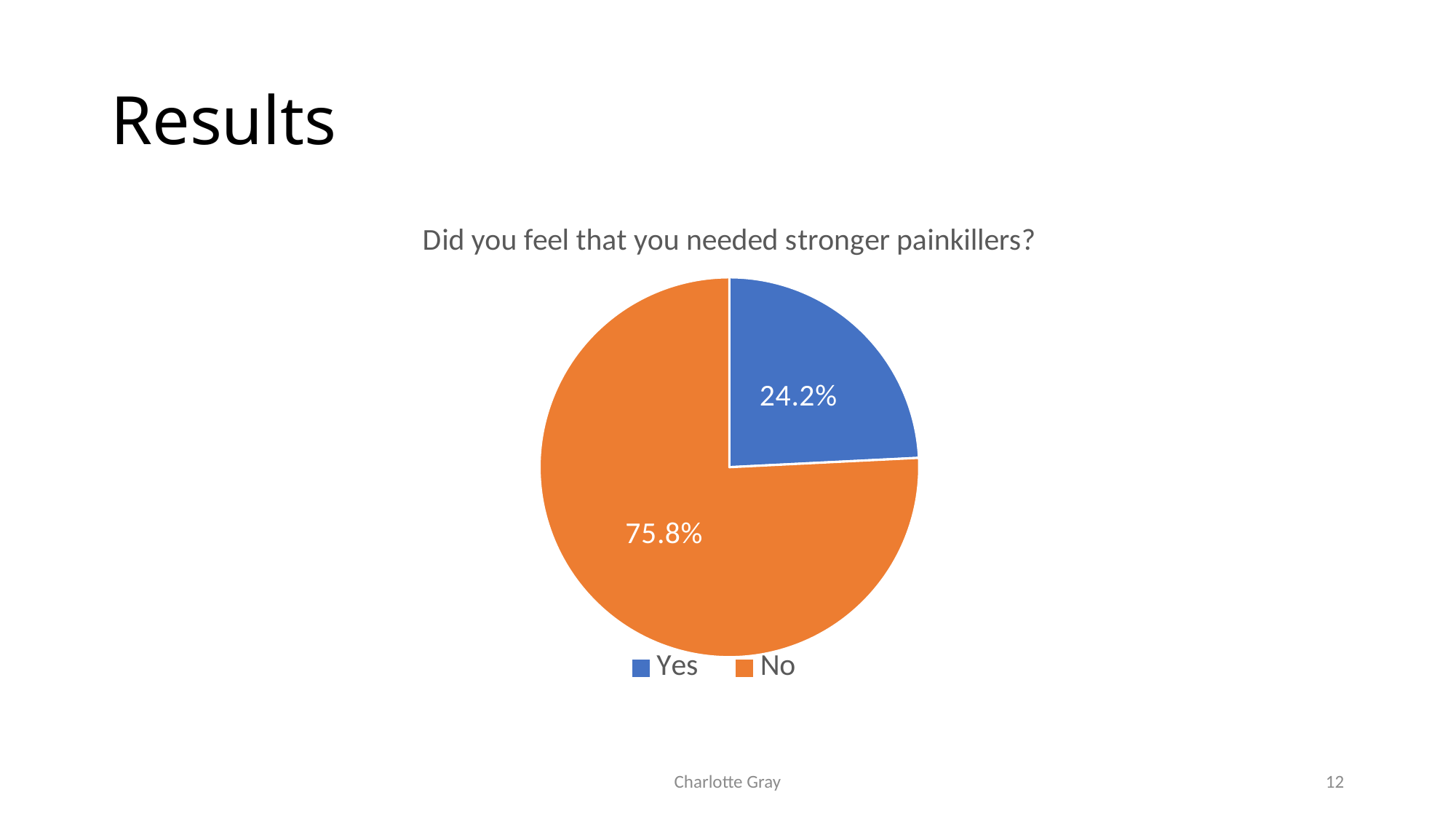
What percentage of respondents answered Yes? 24.2% What colour is the Yes slice? blue Which response has the largest share of the pie? No Which response has the smallest share of the pie? Yes What share of the pie does the No slice represent? 75.8% How many entries does the legend list? 2 What is the difference between the No share and the Yes share? 51.6% What type of chart is shown on the slide? pie chart What is the title of the chart? Did you feel that you needed stronger painkillers? What percentage of respondents answered No? 75.8% Which is larger, the share for Yes or the share for No? No How many slices does the pie chart have? 2